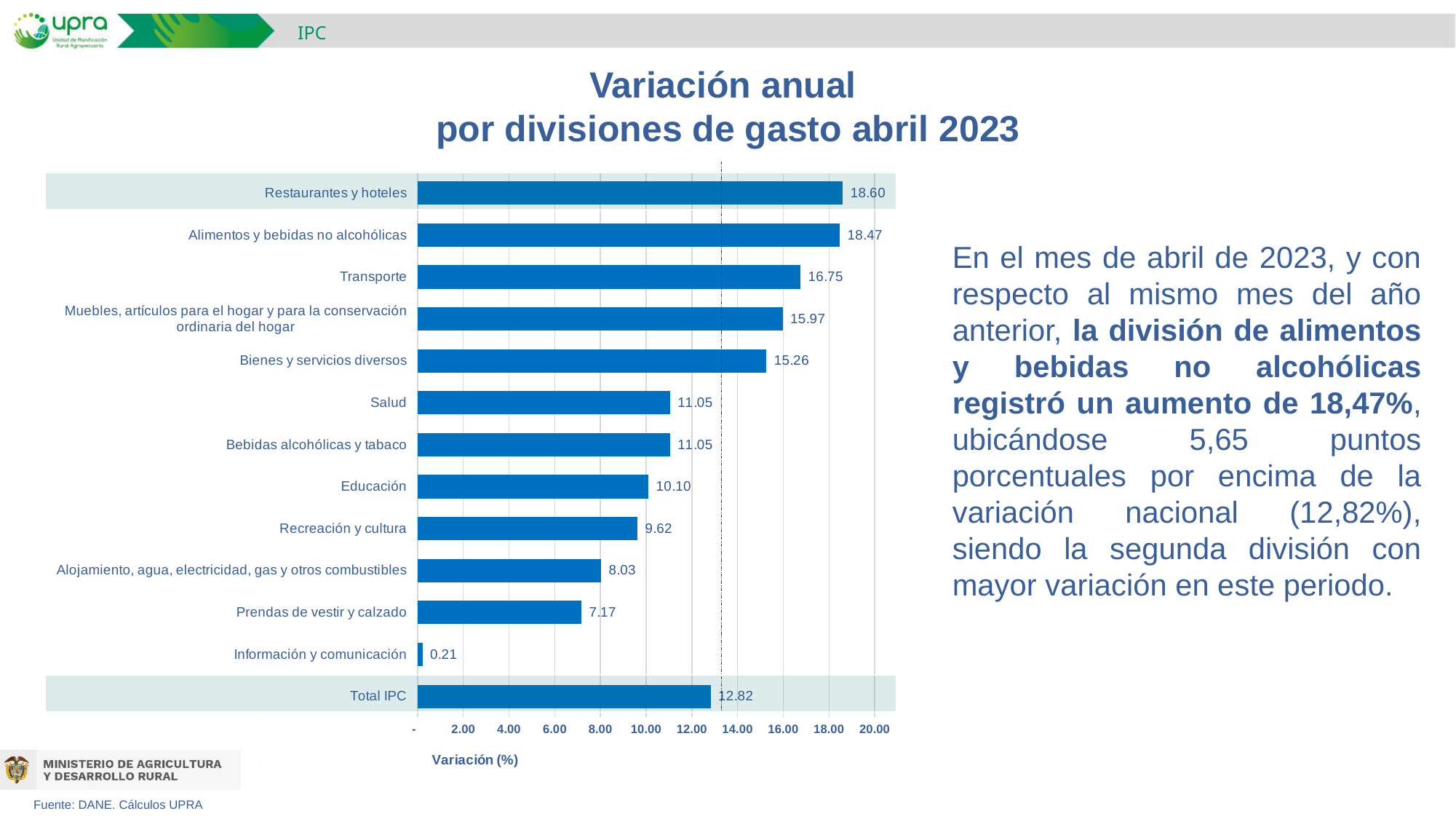
What is the difference between the values for Transporte and Educación? 6.65 Is the value for Bienes y servicios diversos greater or less than 14.00? greater What is the title of the horizontal axis? Variación (%) Which category has the lowest value? Información y comunicación What is the value for Prendas de vestir y calzado? 7.17 What is the value for Total IPC? 12.82 How many bars are shown in the chart? 13 What is the difference between the values for Alimentos y bebidas no alcohólicas and Total IPC? 5.65 What is the value for Transporte? 16.75 Which category has the highest value? Restaurantes y hoteles Which is larger, the value for Recreación y cultura or the value for Alojamiento, agua, electricidad, gas y otros combustibles? Recreación y cultura What kind of chart is shown on the slide? Bar chart